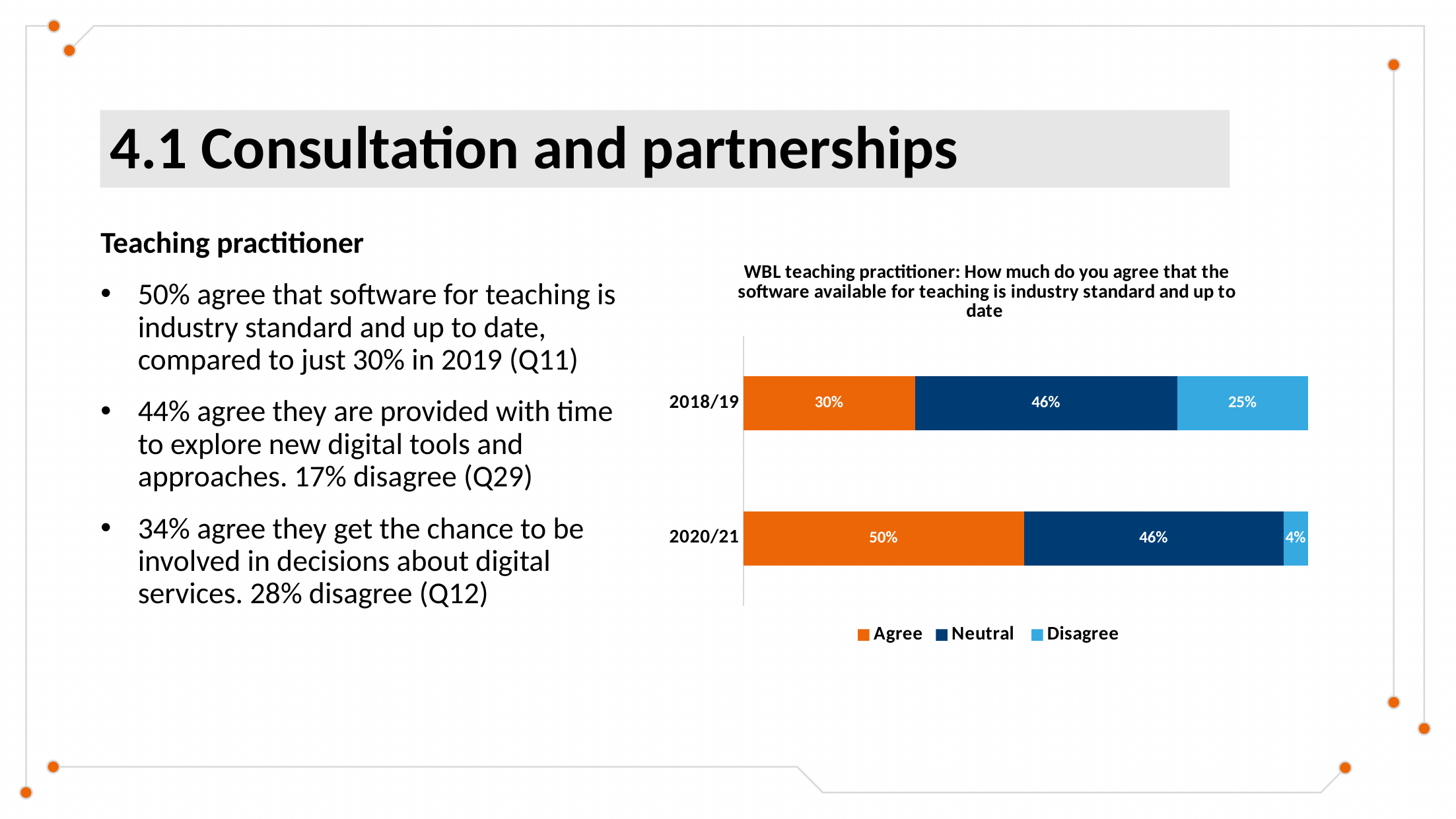
What is the Neutral value for 2020/21? 46% What type of chart is shown on the slide? Stacked bar chart Which response category is the smallest for 2020/21? Disagree How many series does the legend list? 3 Which year has the larger Disagree share, 2018/19 or 2020/21? 2018/19 How many years (categories) are shown in the chart? 2 What is the Disagree value for 2020/21? 4% What percentage of WBL teaching practitioners agreed in 2020/21 that the software available for teaching is industry standard and up to date? 50% By how many percentage points did the Agree share increase from 2018/19 to 2020/21? 20 percentage points Which response category is the largest for 2018/19? Neutral What is the Disagree value for 2018/19? 25% What is the Agree value for 2018/19 in the chart? 30%